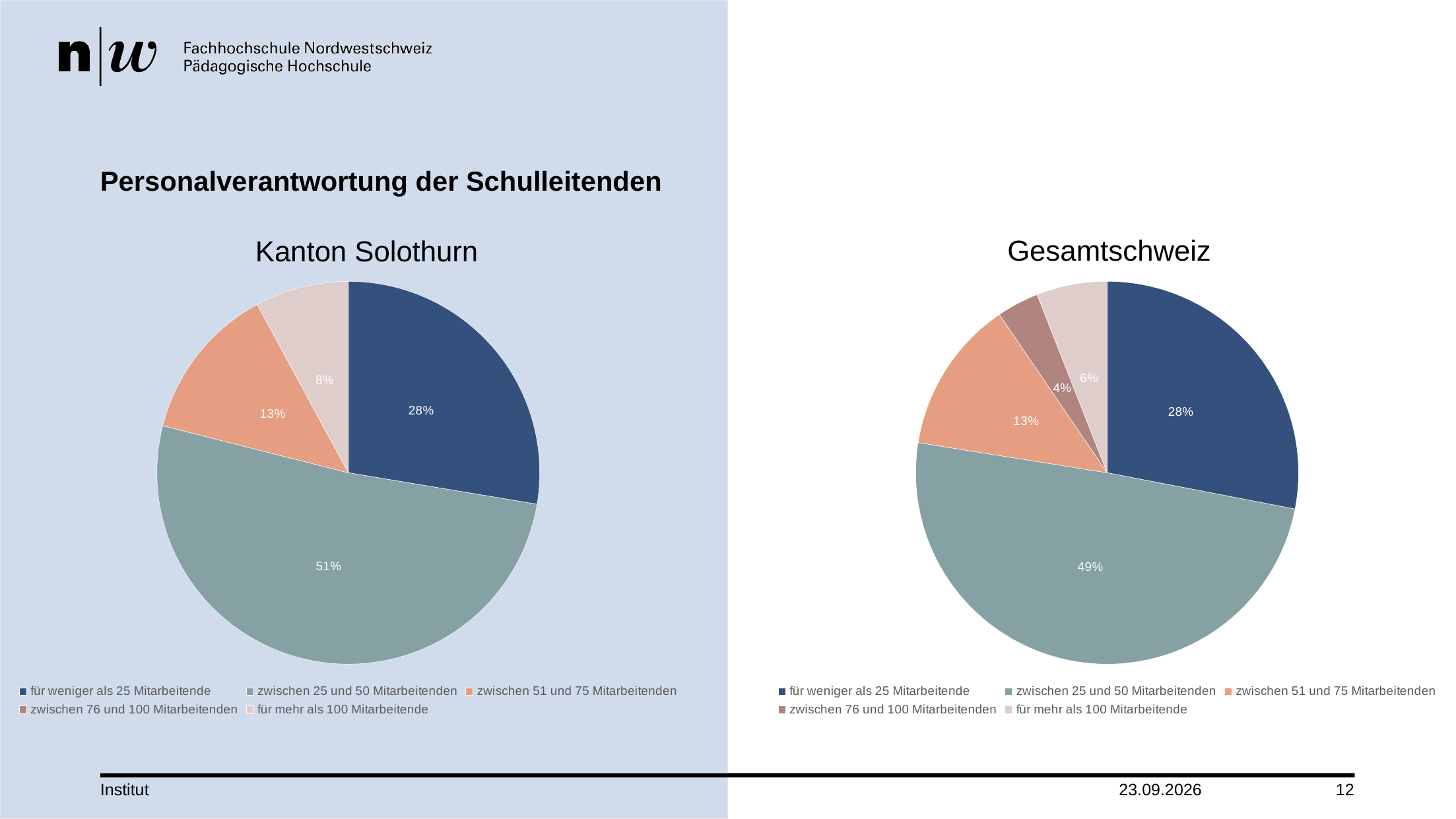
How many entries does the legend of the Gesamtschweiz chart list? 5 In the Gesamtschweiz chart, which category has the smallest slice? zwischen 76 und 100 Mitarbeitenden In the Gesamtschweiz chart, what share is shown for 'zwischen 76 und 100 Mitarbeitenden'? 4% What type of chart is used for Kanton Solothurn? Pie chart In the Gesamtschweiz chart, what share is shown for 'zwischen 25 und 50 Mitarbeitenden'? 49% In the Gesamtschweiz chart, which category has the largest slice? zwischen 25 und 50 Mitarbeitenden How many slices does the Gesamtschweiz pie chart show? 5 In the Gesamtschweiz chart, which is larger: the share for 'für mehr als 100 Mitarbeitende' or for 'zwischen 76 und 100 Mitarbeitenden'? für mehr als 100 Mitarbeitende In the Kanton Solothurn chart, which category has the largest slice? zwischen 25 und 50 Mitarbeitenden What is the difference between the 'zwischen 25 und 50 Mitarbeitenden' share in the Kanton Solothurn chart and in the Gesamtschweiz chart? 2 percentage points In the Kanton Solothurn chart, what share is shown for 'für mehr als 100 Mitarbeitende'? 8% In the Kanton Solothurn chart, what share is shown for 'zwischen 25 und 50 Mitarbeitenden'? 51%